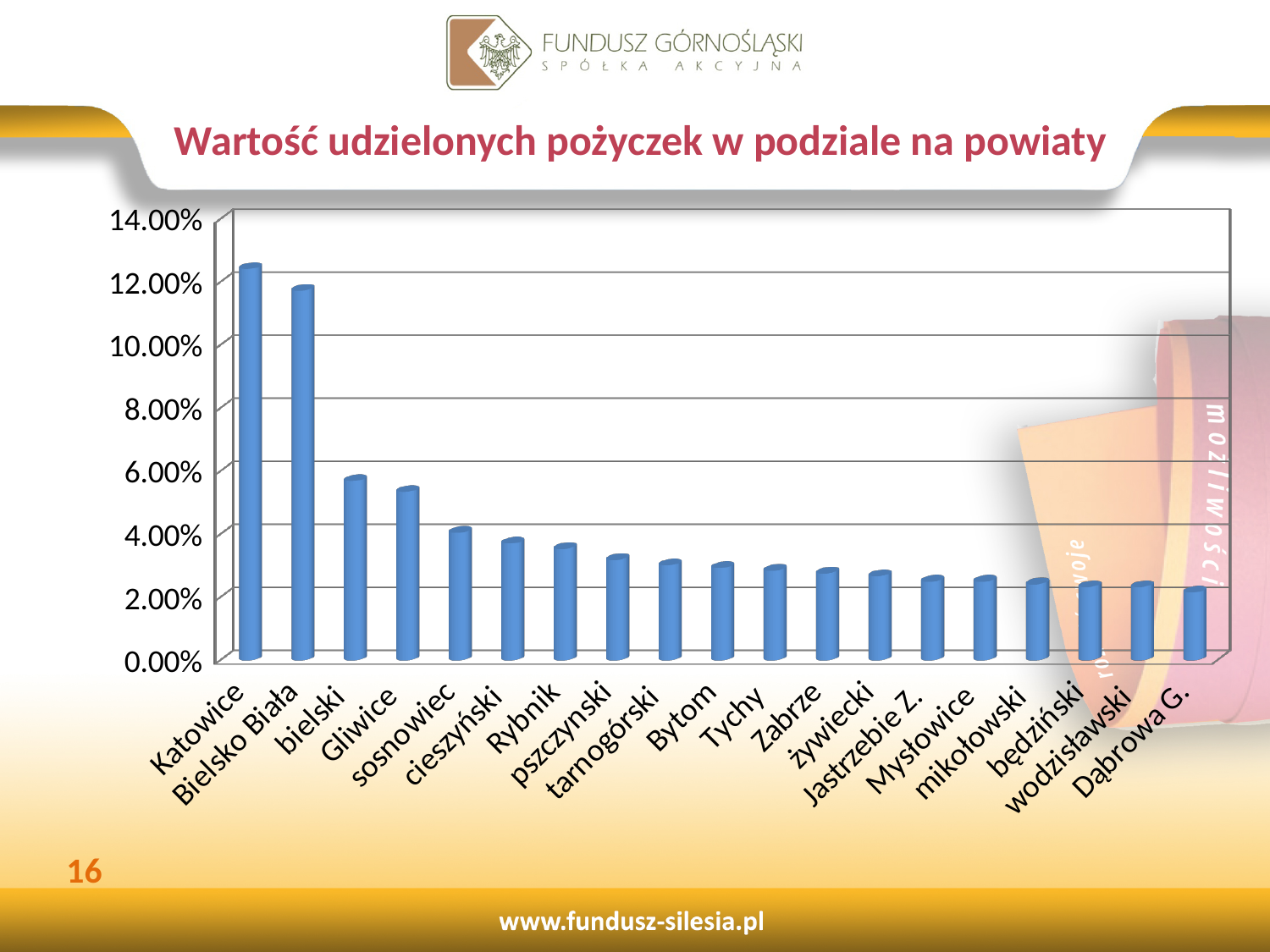
Is the value for Bielsko Biała greater or less than 10.00%? greater Is the value for Dąbrowa G. greater or less than 4.00%? less Is the value for cieszyński greater or less than 4.00%? less What kind of chart is shown on the slide? bar chart What is the title of the chart? Wartość udzielonych pożyczek w podziale na powiaty Which category has the highest value in the chart? Katowice Which has a larger value, Gliwice or sosnowiec? Gliwice Do the values generally rise or fall moving from left to right along the x axis? fall How many categories (powiaty) are shown on the x axis of the chart? 19